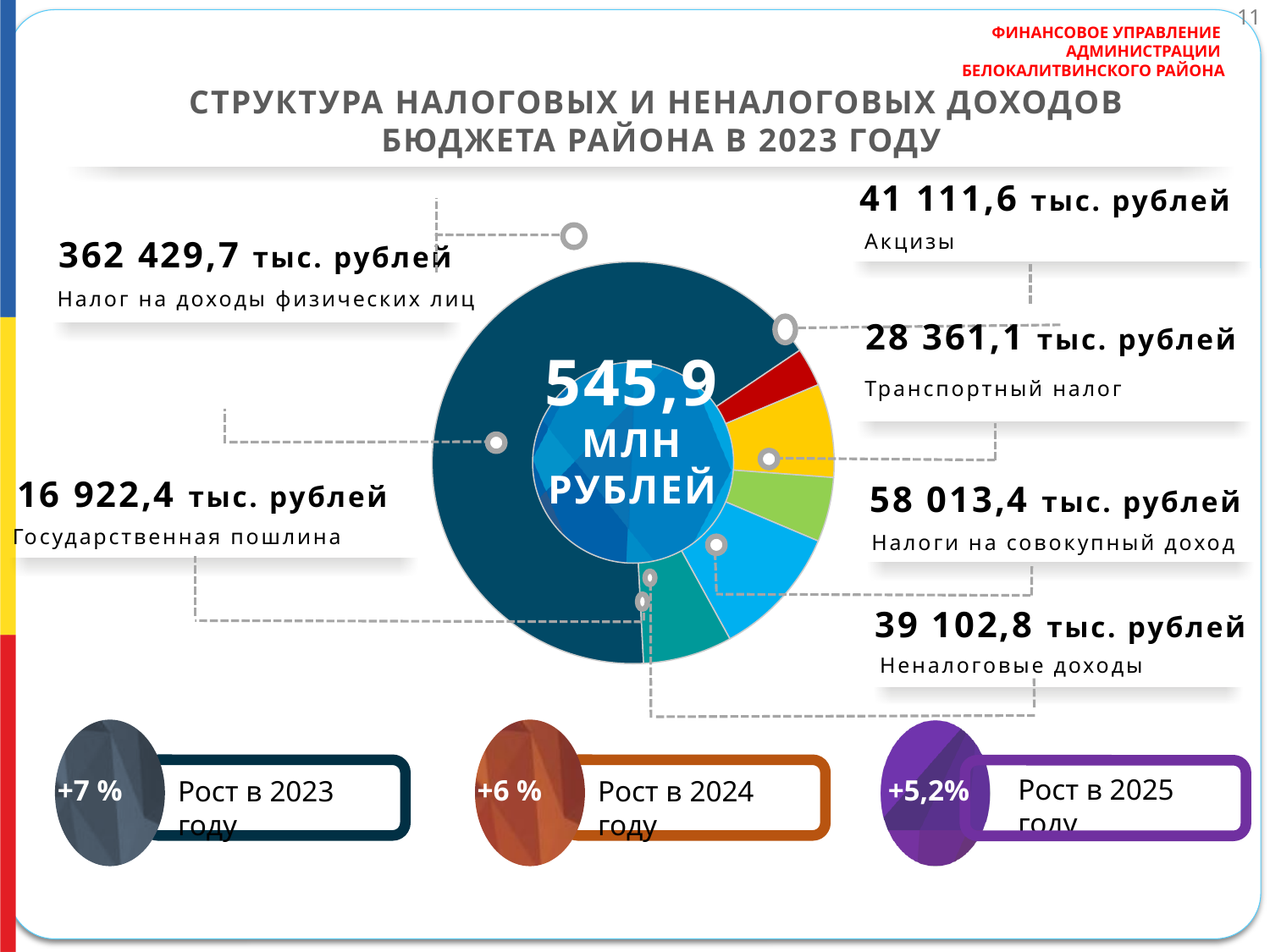
Which is larger: Акцизы or Транспортный налог? Акцизы Which category has the largest value in the chart? Налог на доходы физических лиц What is the value shown for Налоги на совокупный доход? 58 013,4 тыс. рублей What is the value shown for Акцизы? 41 111,6 тыс. рублей What is the difference between Налоги на совокупный доход and Акцизы? 16 901,8 тыс. рублей What is the value shown for Государственная пошлина? 16 922,4 тыс. рублей What is the value shown for Транспортный налог? 28 361,1 тыс. рублей What is the value shown for Налог на доходы физических лиц? 362 429,7 тыс. рублей What is the value shown for Неналоговые доходы? 39 102,8 тыс. рублей What total is printed in the centre of the chart? 545,9 млн рублей How many categories are shown in the chart? 6 Which category has the smallest value in the chart? Государственная пошлина